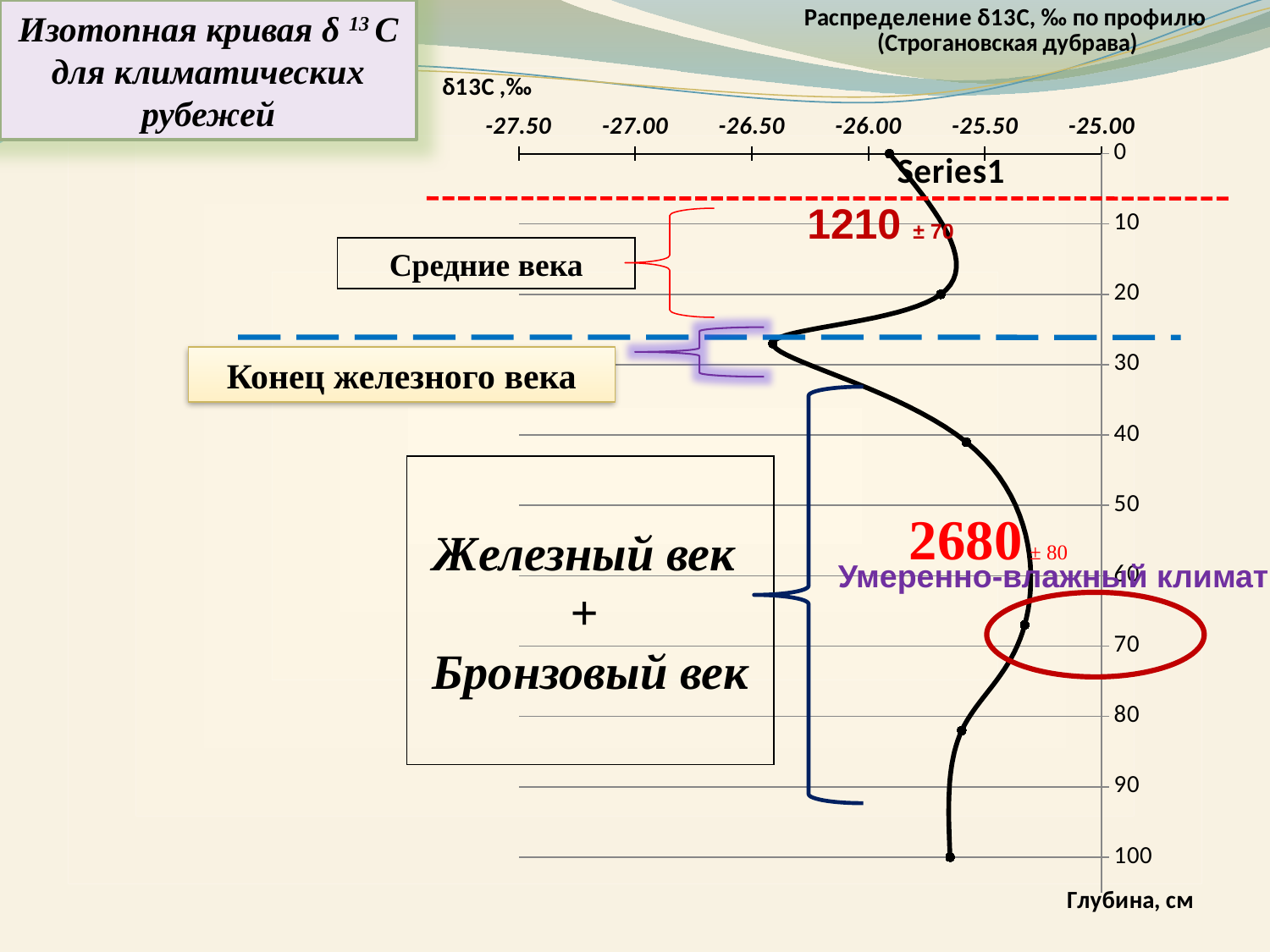
What kind of chart is shown on the slide? line chart What is the largest depth value shown on the vertical axis? 100 Between depths 0 cm and 20 cm, does the δ13C value increase or decrease? increase What is the title of the chart? Распределение δ13C, ‰ по профилю (Строгановская дубрава) Which has the larger (less negative) δ13C value: the point at 0 cm depth or the point at 40 cm depth? 40 cm Is the δ13C value at a depth of 100 cm greater or less than -25.00? less Is the δ13C value at a depth of 40 cm greater or less than -26.00? greater What is the label of the vertical axis of the chart? Глубина, см How many data points are plotted on the curve? 7 Is the δ13C value at a depth of 100 cm greater or less than -26.00? greater